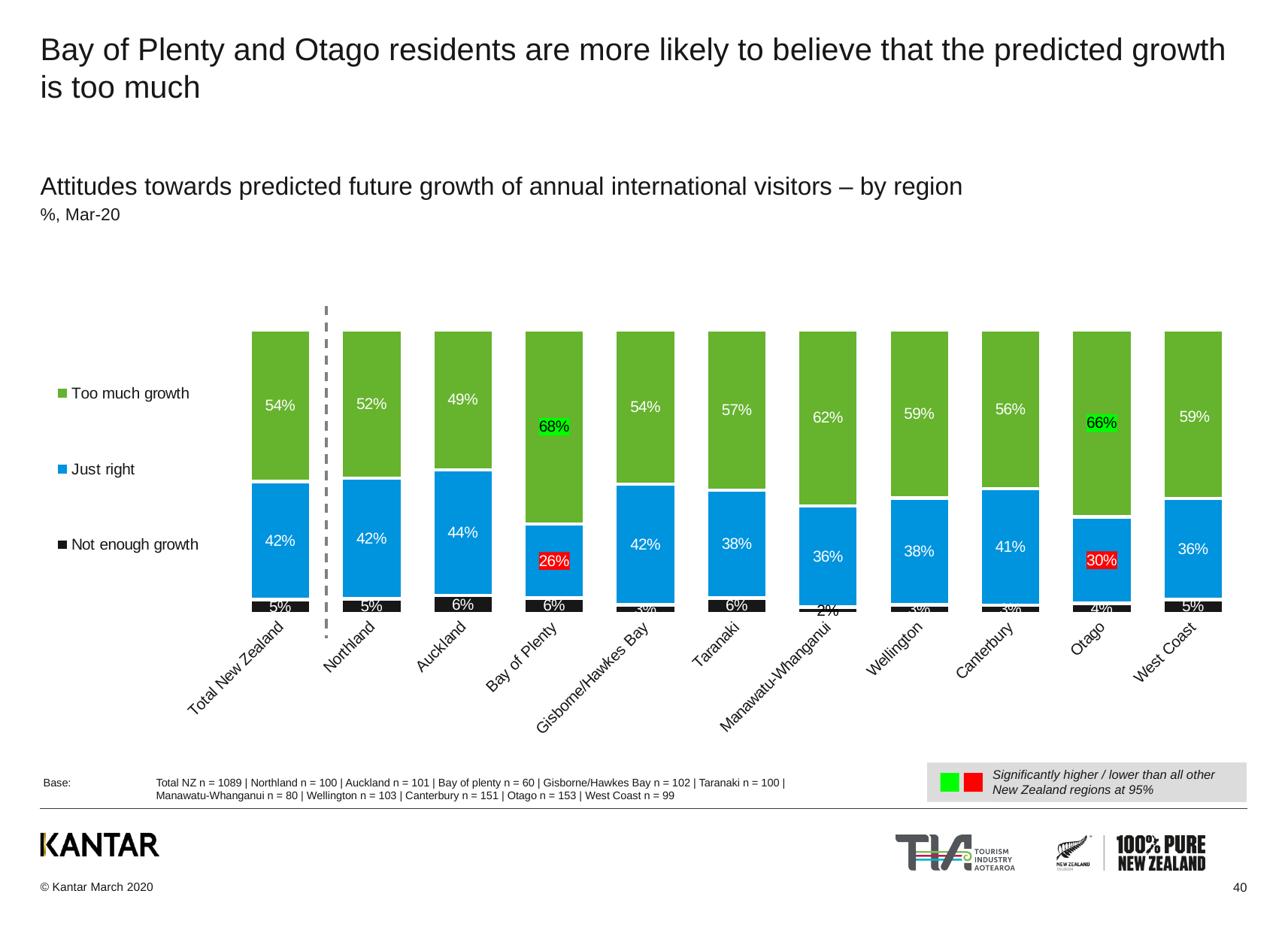
Which region has the highest 'Too much growth' percentage? Bay of Plenty What percentage of Bay of Plenty residents say there is too much growth? 68% What percentage of Auckland residents say there is not enough growth? 6% How many series does the legend list? 3 Which region has the lowest 'Just right' percentage? Bay of Plenty Which region has the lowest 'Too much growth' percentage? Auckland What is the 'Too much growth' value for Total New Zealand? 54% What type of chart is shown on the slide? Stacked bar chart Which has a higher 'Just right' value, Canterbury or Taranaki? Canterbury What is the difference in percentage points between the 'Too much growth' values for Bay of Plenty and Auckland? 19 How many bars (regions including Total New Zealand) are shown in the chart? 11 What is the 'Just right' value for Otago? 30%